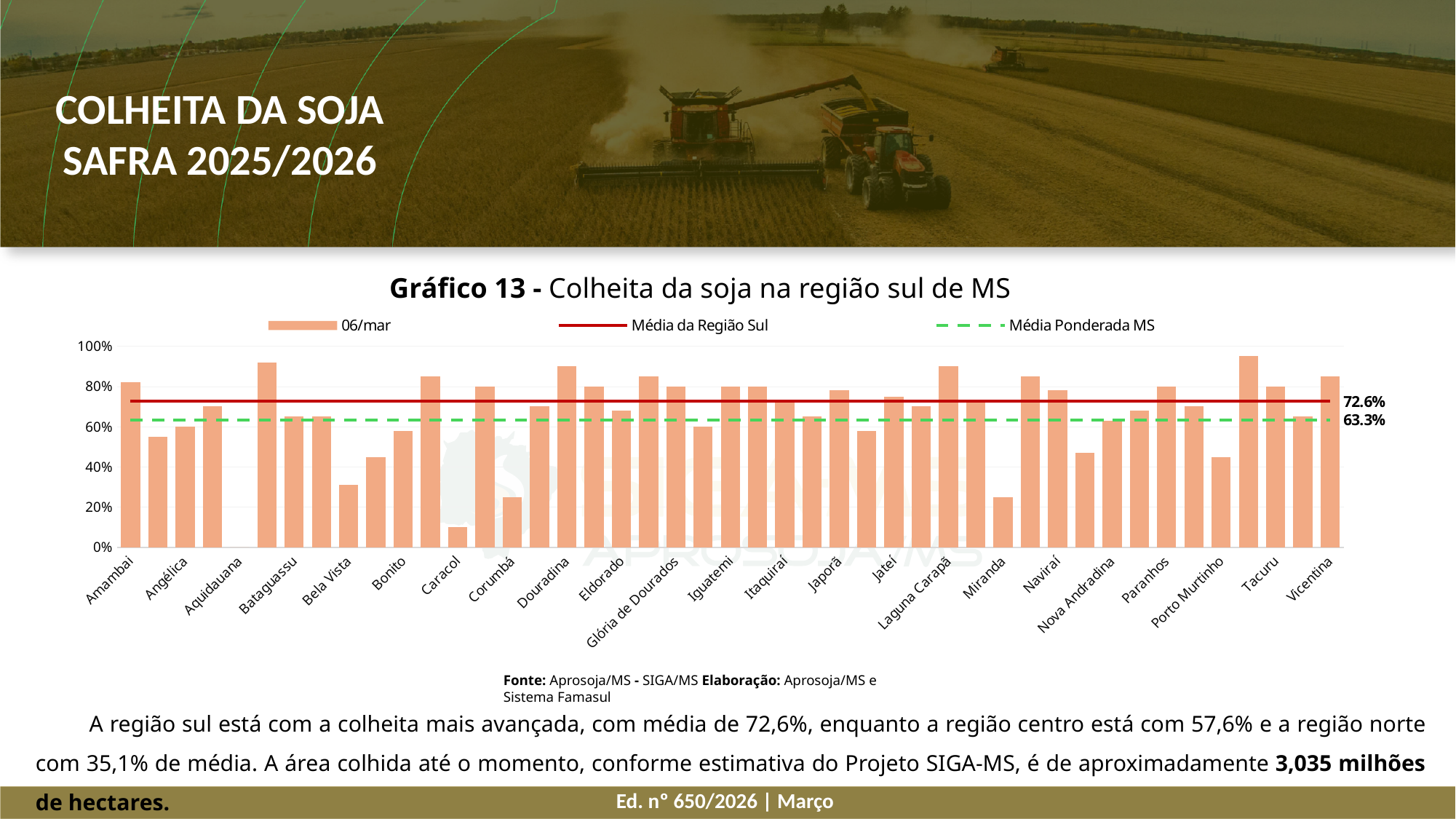
What is the title of the chart? Gráfico 13 - Colheita da soja na região sul de MS What is the difference between the Média da Região Sul (72.6%) and the Média Ponderada MS (63.3%)? 9.3% What kind of chart is shown on the slide? Combination bar and line chart Which is larger, the Média da Região Sul or the Média Ponderada MS? Média da Região Sul What value is labelled for the Média da Região Sul line? 72.6% How many series does the chart legend list? 3 Is the value for Bela Vista greater or less than 40%? less Which has the larger value, Douradina or Bela Vista? Douradina Is the value for Caracol greater or less than 20%? less What value is labelled for the Média Ponderada MS line? 63.3% Which has the larger value, Tacuru or Caracol? Tacuru